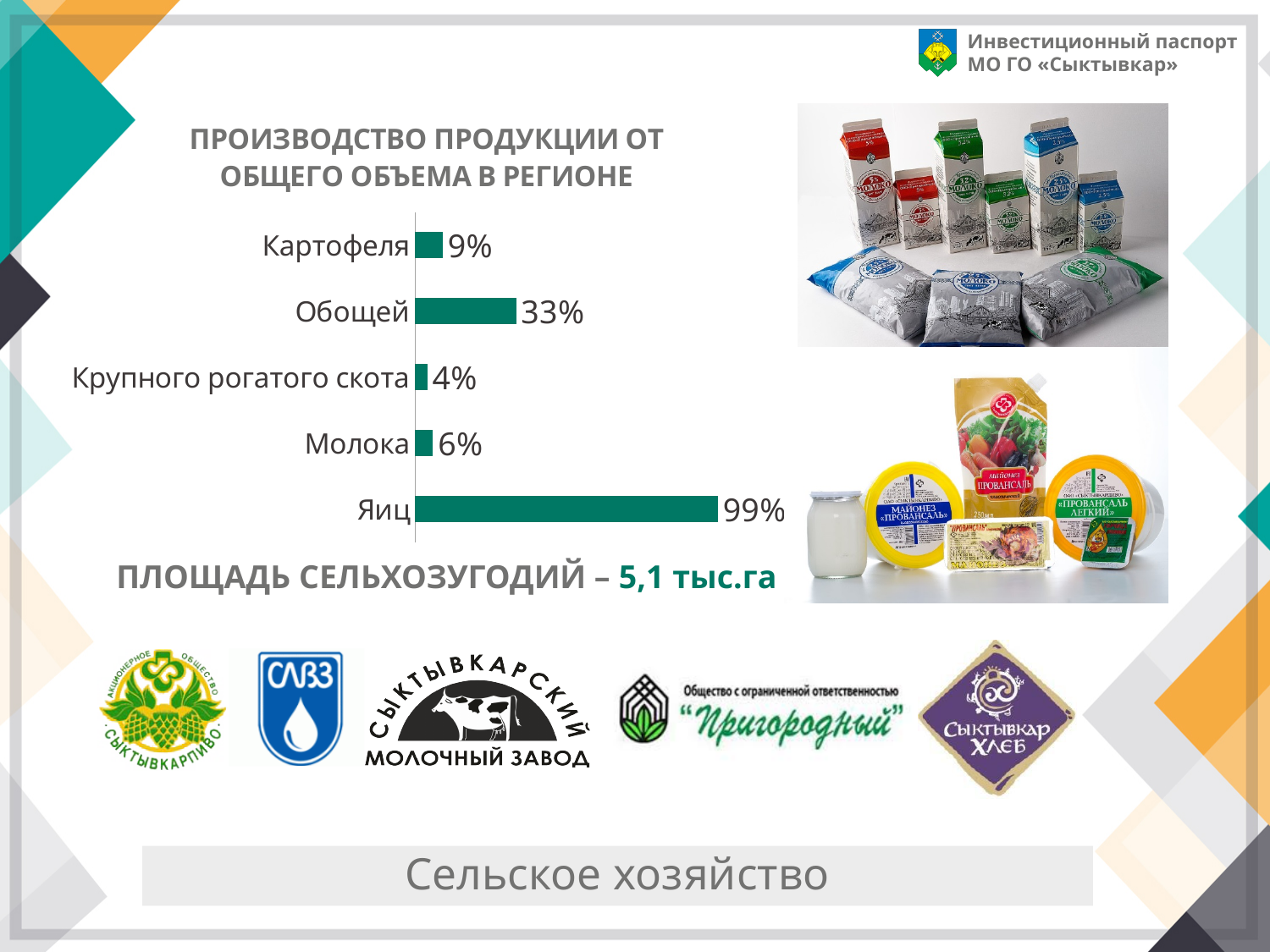
What kind of chart is shown on the slide? Bar chart Which category has the highest value? Яиц What is the value for Яиц? 99% What is the value for Молока? 6% What is the value for Картофеля? 9% What is the value for Обощей? 33% What is the value for Крупного рогатого скота? 4% What is the title of the chart? ПРОИЗВОДСТВО ПРОДУКЦИИ ОТ ОБЩЕГО ОБЪЕМА В РЕГИОНЕ How many categories are shown in the chart? 5 Which is larger, the value for Картофеля or the value for Молока? Картофеля What is the difference between the values for Яиц and Обощей? 66% Which category has the lowest value? Крупного рогатого скота